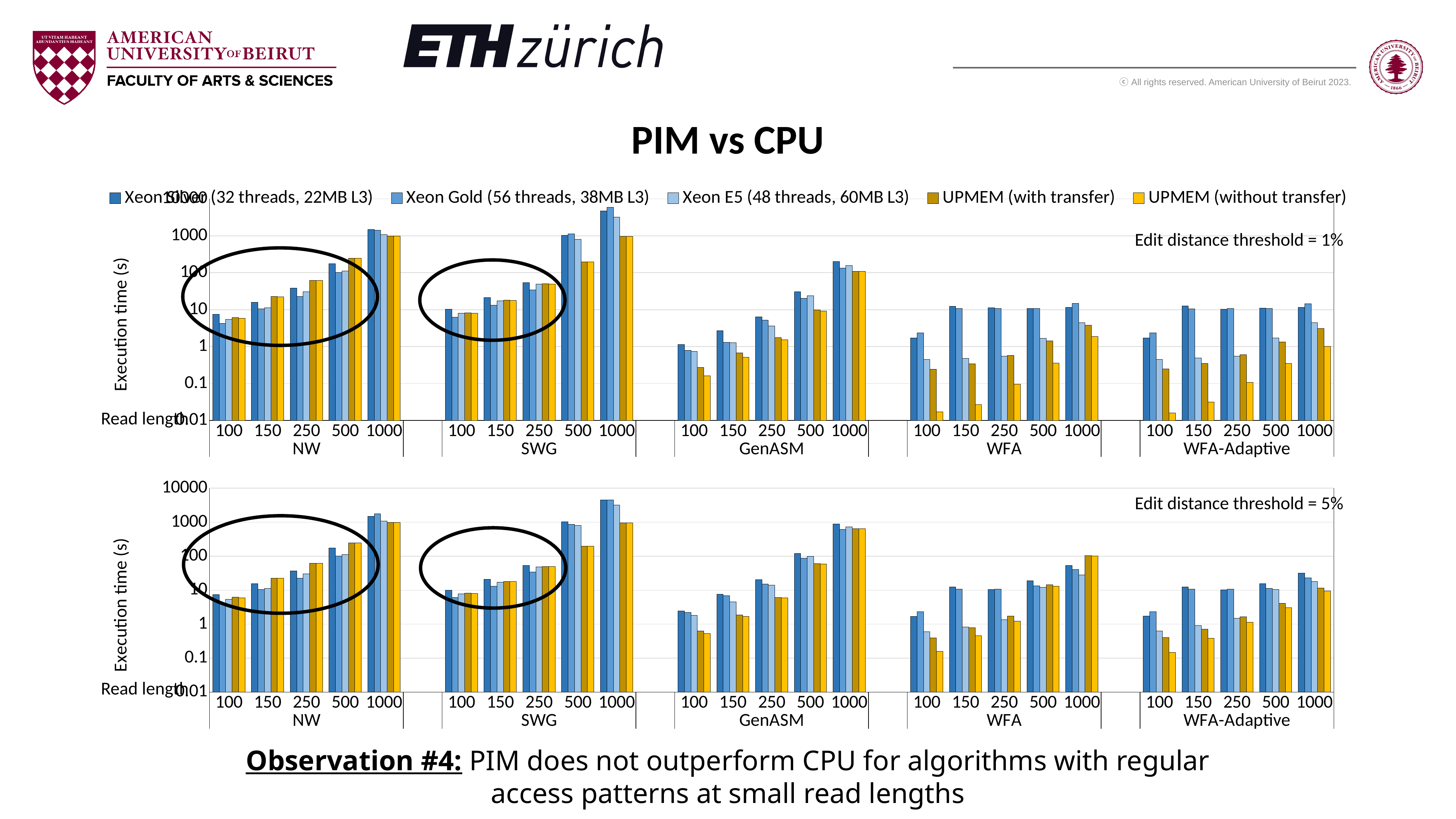
What kind of chart is shown for Edit distance threshold = 1%? bar chart In the Edit distance threshold = 5% chart, which is larger for SWG at read length 500: Xeon Silver (32 threads, 22MB L3) or UPMEM (without transfer)? Xeon Silver (32 threads, 22MB L3) In the Edit distance threshold = 1% chart, is the UPMEM (without transfer) value for WFA-Adaptive at read length 100 greater or less than 0.1? less In the Edit distance threshold = 5% chart, is the UPMEM (with transfer) value for GenASM at read length 100 greater or less than 1? less How many read lengths are plotted for each algorithm in the Edit distance threshold = 1% chart? 5 In the Edit distance threshold = 1% chart, is the Xeon Silver (32 threads, 22MB L3) value for NW at read length 1000 greater or less than 1000? greater How many series does the legend list? 5 In the Edit distance threshold = 1% chart, which is larger for WFA at read length 100: Xeon Silver (32 threads, 22MB L3) or UPMEM (without transfer)? Xeon Silver (32 threads, 22MB L3) What is the y-axis label of the charts? Execution time (s) In the Edit distance threshold = 1% chart, does the Xeon Silver (32 threads, 22MB L3) execution time for NW rise or fall as read length increases from 100 to 1000? rise How many algorithm groups are shown along the x axis of the Edit distance threshold = 5% chart? 5